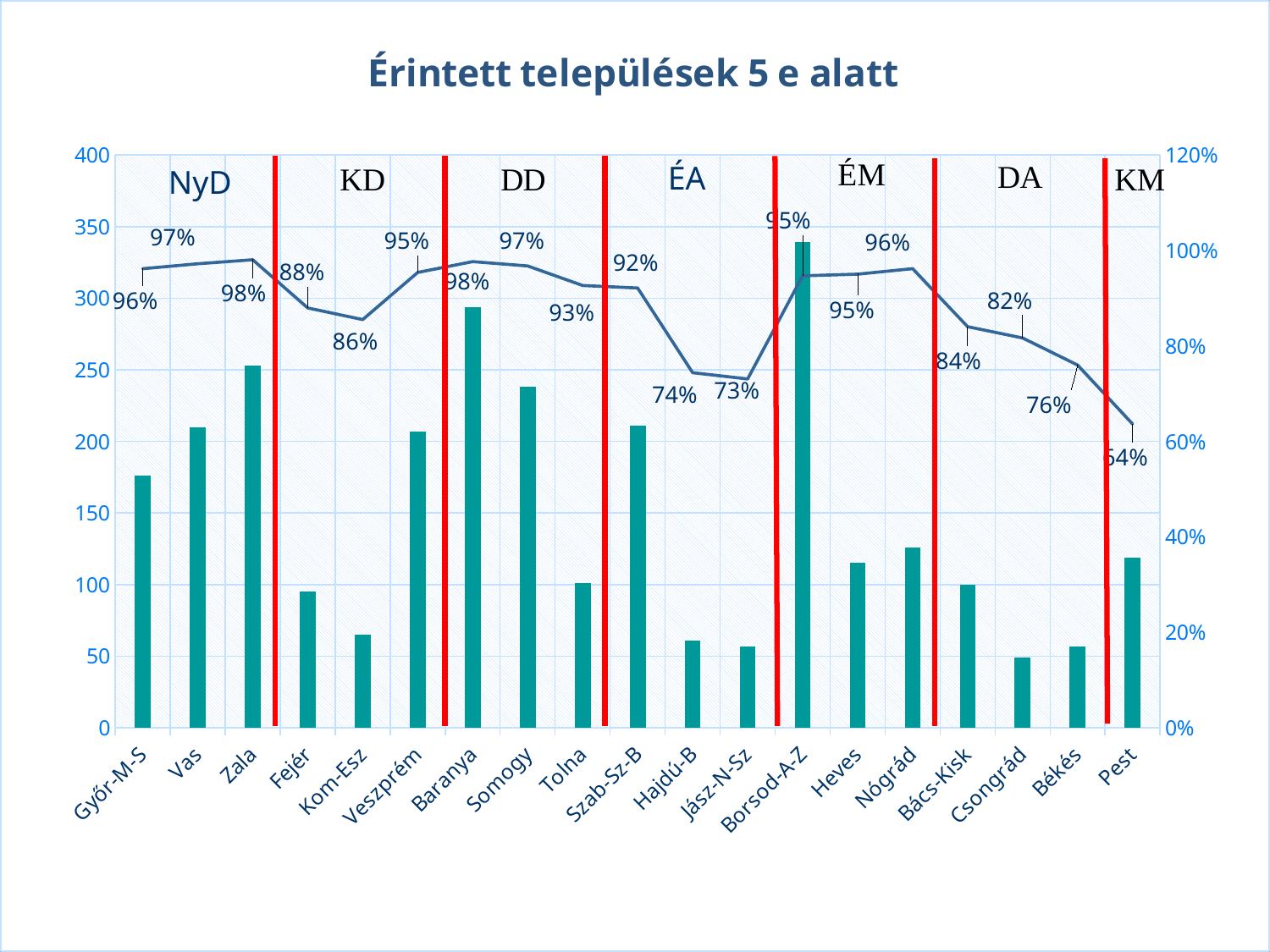
Which category has the tallest bar? Borsod-A-Z What percentage is shown for Pest on the line? 64% What percentage is shown for Veszprém on the line? 95% How many categories are shown on the x axis? 19 What percentage is shown for Jász-N-Sz on the line? 73% Is the bar value for Borsod-A-Z greater or less than 300? greater Which category has the lowest percentage on the line? Pest What is the difference between the percentage for Zala and the percentage for Pest? 34% Is the bar value for Vas greater or less than 200? greater Which has the taller bar, Borsod-A-Z or Heves? Borsod-A-Z What is the title of the chart? Érintett települések 5 e alatt